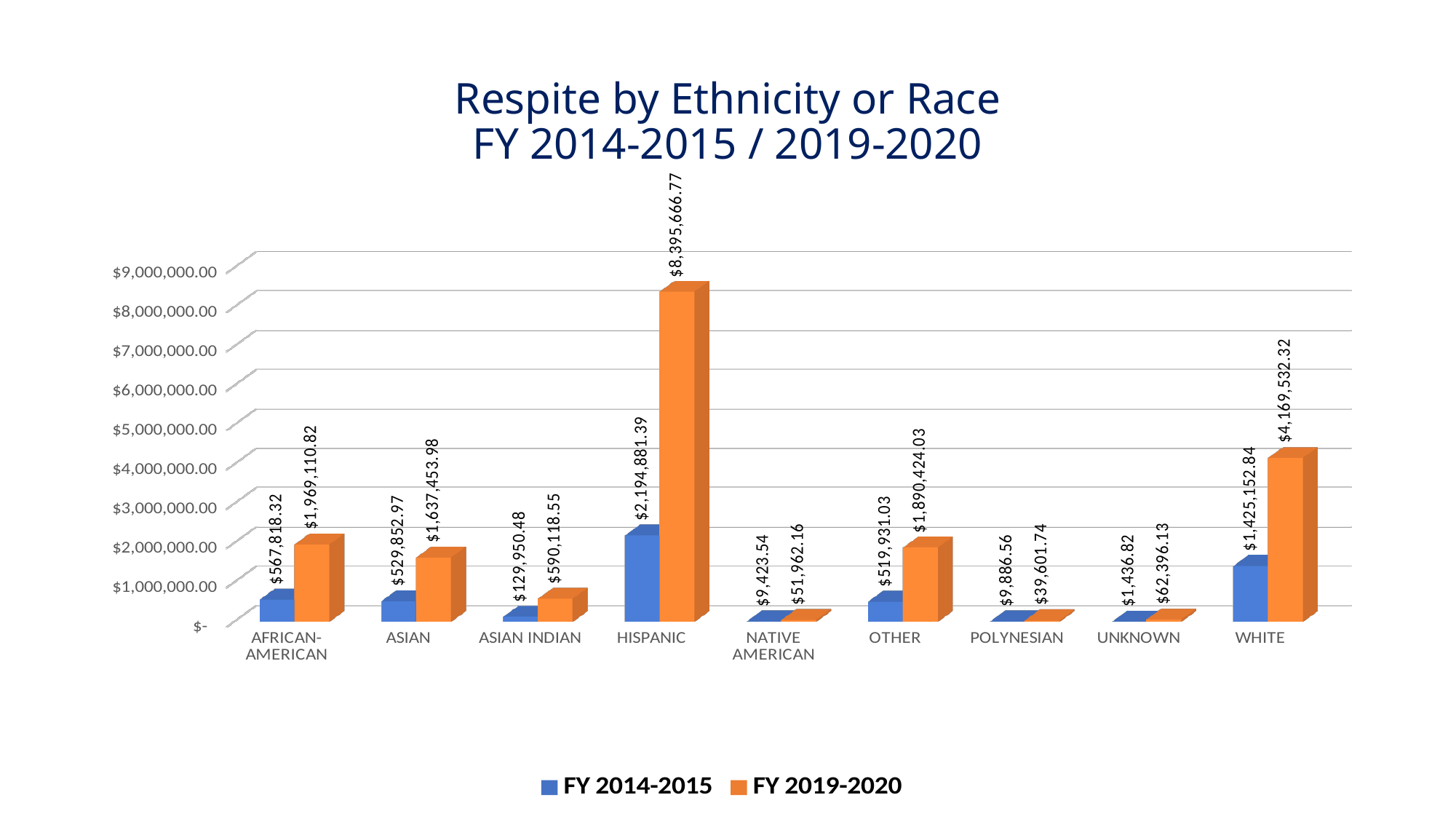
Which category has the highest FY 2019-2020 value? Hispanic What is the FY 2019-2020 value for Hispanic? $8,395,666.77 What kind of chart is shown on the slide? bar chart Which category has the lowest FY 2014-2015 value? Unknown What is the FY 2014-2015 value for Native American? $9,423.54 What is the FY 2019-2020 value for Asian Indian? $590,118.55 How many series does the legend list? 2 What is the difference between the FY 2019-2020 and FY 2014-2015 values for Hispanic? $6,200,785.38 Is the FY 2019-2020 value for White greater or less than $3,000,000.00? greater What is the FY 2014-2015 value for White? $1,425,152.84 How many ethnicity or race categories are shown on the x axis? 9 Which is larger for Other: the FY 2014-2015 value or the FY 2019-2020 value? FY 2019-2020